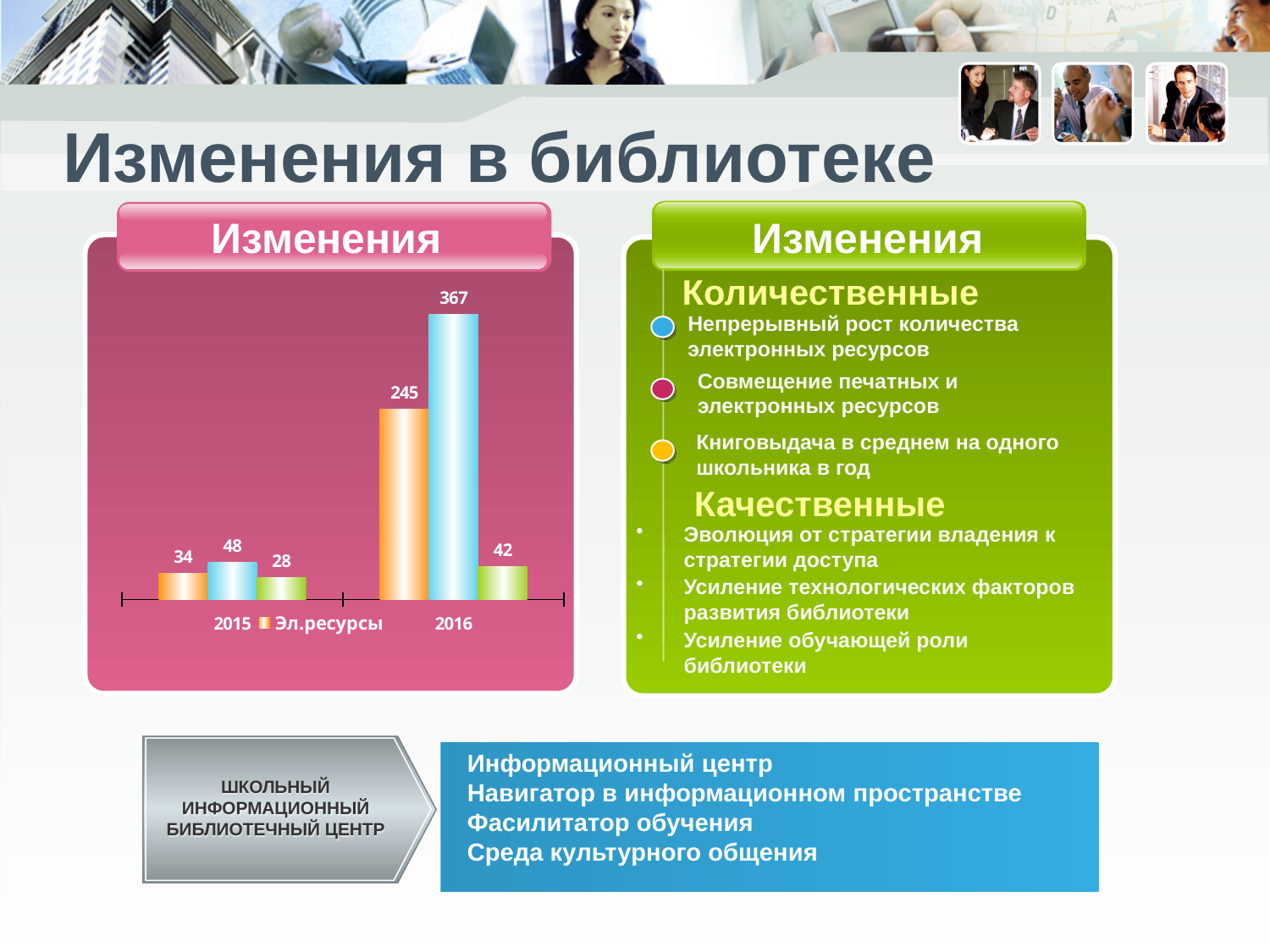
By how much did Эл.ресурсы increase from 2015 to 2016? 211 In 2016, which bar is taller: the blue bar or the orange Эл.ресурсы bar? the blue bar What kind of chart is shown on the slide? bar chart Does the value of Эл.ресурсы rise or fall from 2015 to 2016? rise What is the value of Эл.ресурсы for 2016? 245 What is the value of the blue bar for 2015? 48 What is the difference between the blue bar values for 2016 and 2015? 319 What is the value of the green bar for 2016? 42 What is the value of Эл.ресурсы for 2015? 34 How many year categories are shown on the x axis of the chart? 2 What is the lowest value labelled on the chart? 28 What is the highest value labelled on the chart? 367